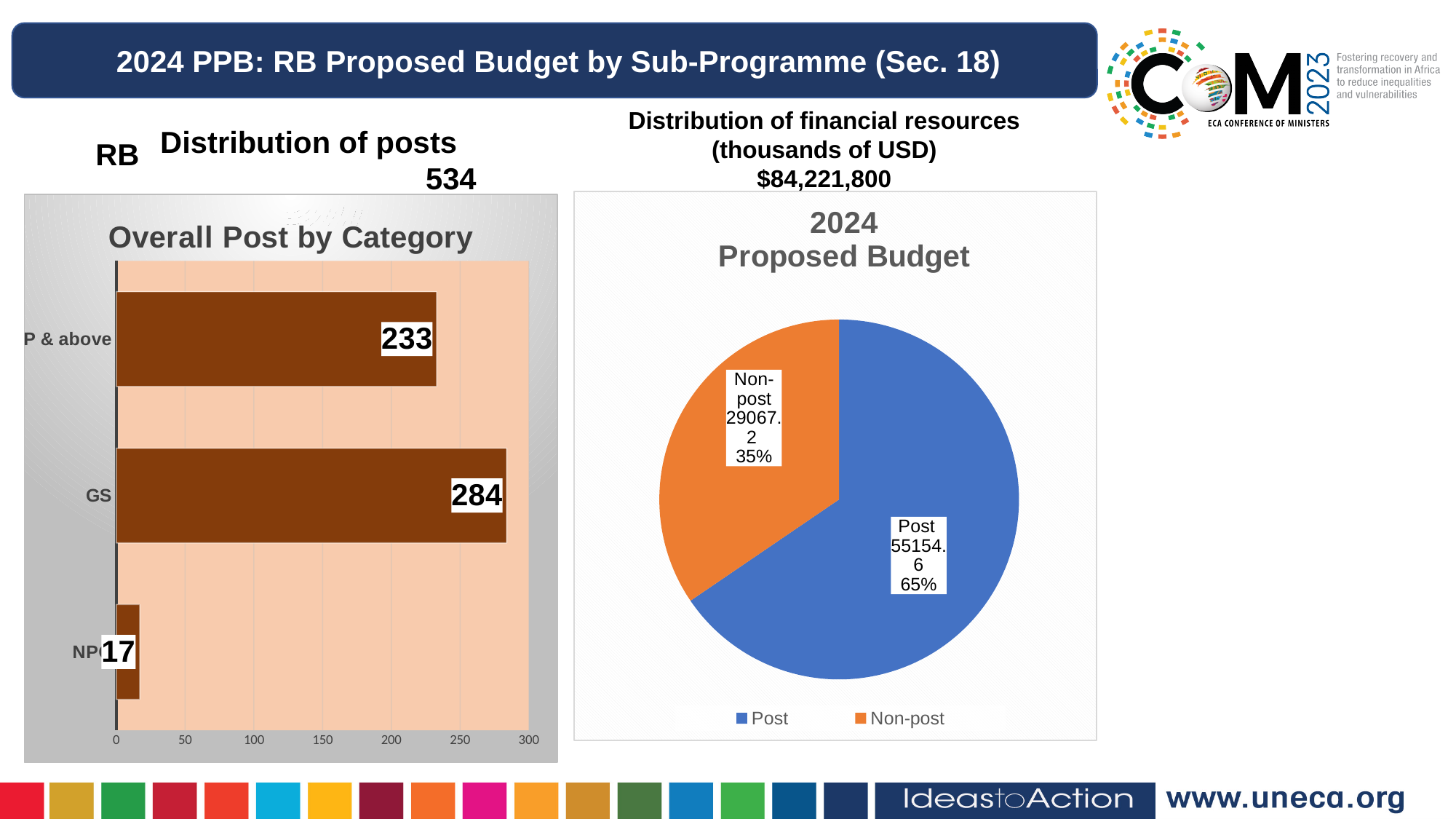
What kind of chart is the '2024 Proposed Budget' chart? Pie chart In the '2024 Proposed Budget' chart, what value is shown for Post? 55154.6 What kind of chart is the 'Overall Post by Category' chart? Bar chart How many entries does the legend of the '2024 Proposed Budget' chart list? 2 In the 'Overall Post by Category' chart, what is the difference between the GS value and the P & above value? 51 In the 'Overall Post by Category' chart, how many categories are shown? 3 In the 'Overall Post by Category' chart, what is the value for GS? 284 In the 'Overall Post by Category' chart, what is the value for P & above? 233 In the 'Overall Post by Category' chart, which category has the highest value? GS In the '2024 Proposed Budget' chart, what share of the pie is Non-post? 35% In the 'Overall Post by Category' chart, which category has the lowest value? NPO In the '2024 Proposed Budget' chart, which is larger, Post or Non-post? Post